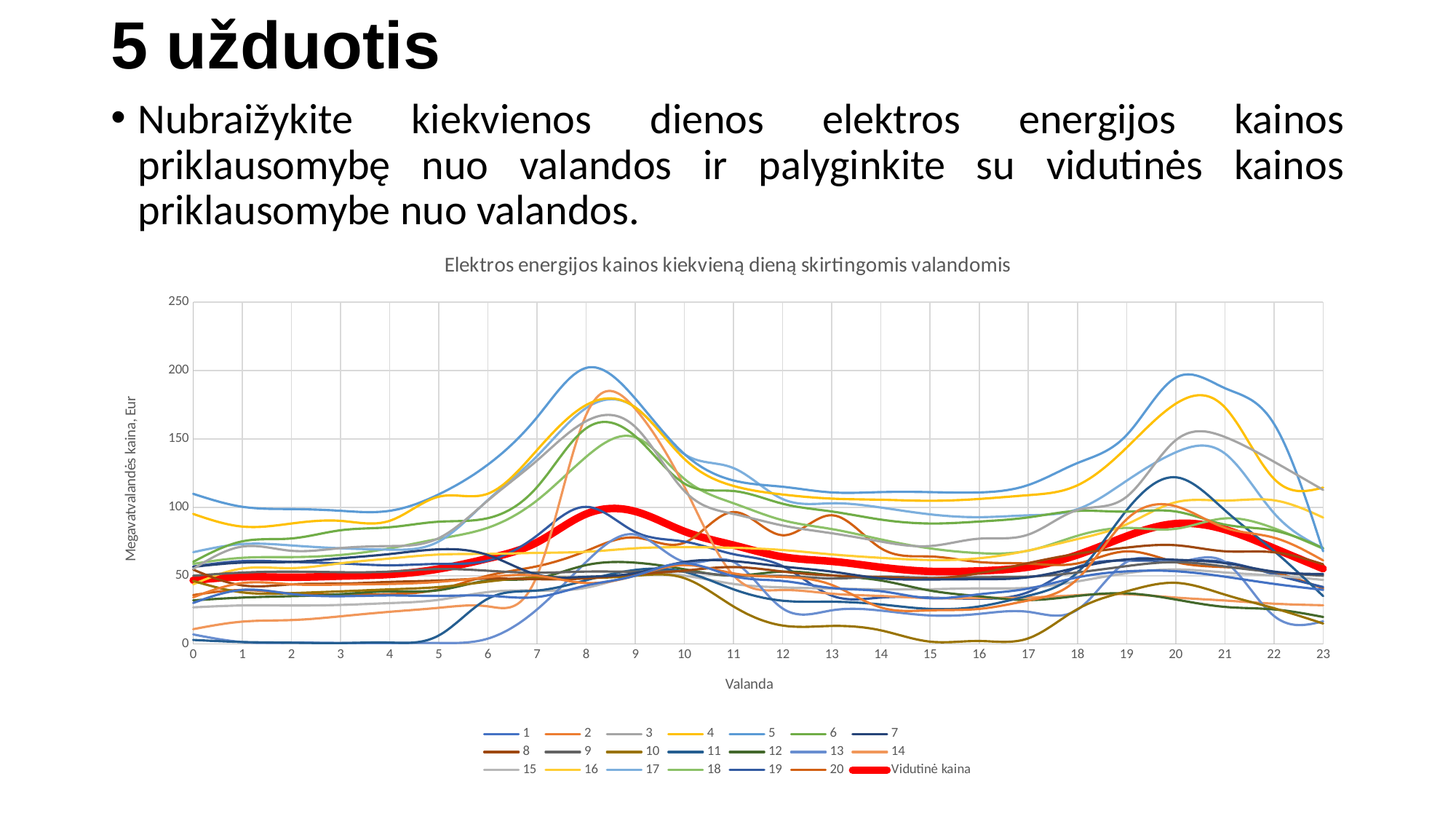
How many hour values are shown along the x axis of the chart? 24 What is the label of the y axis of the chart? Megavatvalandės kaina, Eur Is the value of series 5 at hour 20 greater or less than 150? greater What kind of chart is shown on the slide? line chart Is the value of series 10 at hour 15 greater or less than 50? less Is the value of the Vidutinė kaina line at hour 15 greater or less than 100? less How many series does the chart legend list? 21 Which series has the highest value at hour 8? 5 What is the title of the chart? Elektros energijos kainos kiekvieną dieną skirtingomis valandomis Does the Vidutinė kaina line rise or fall between hour 5 and hour 8? rise